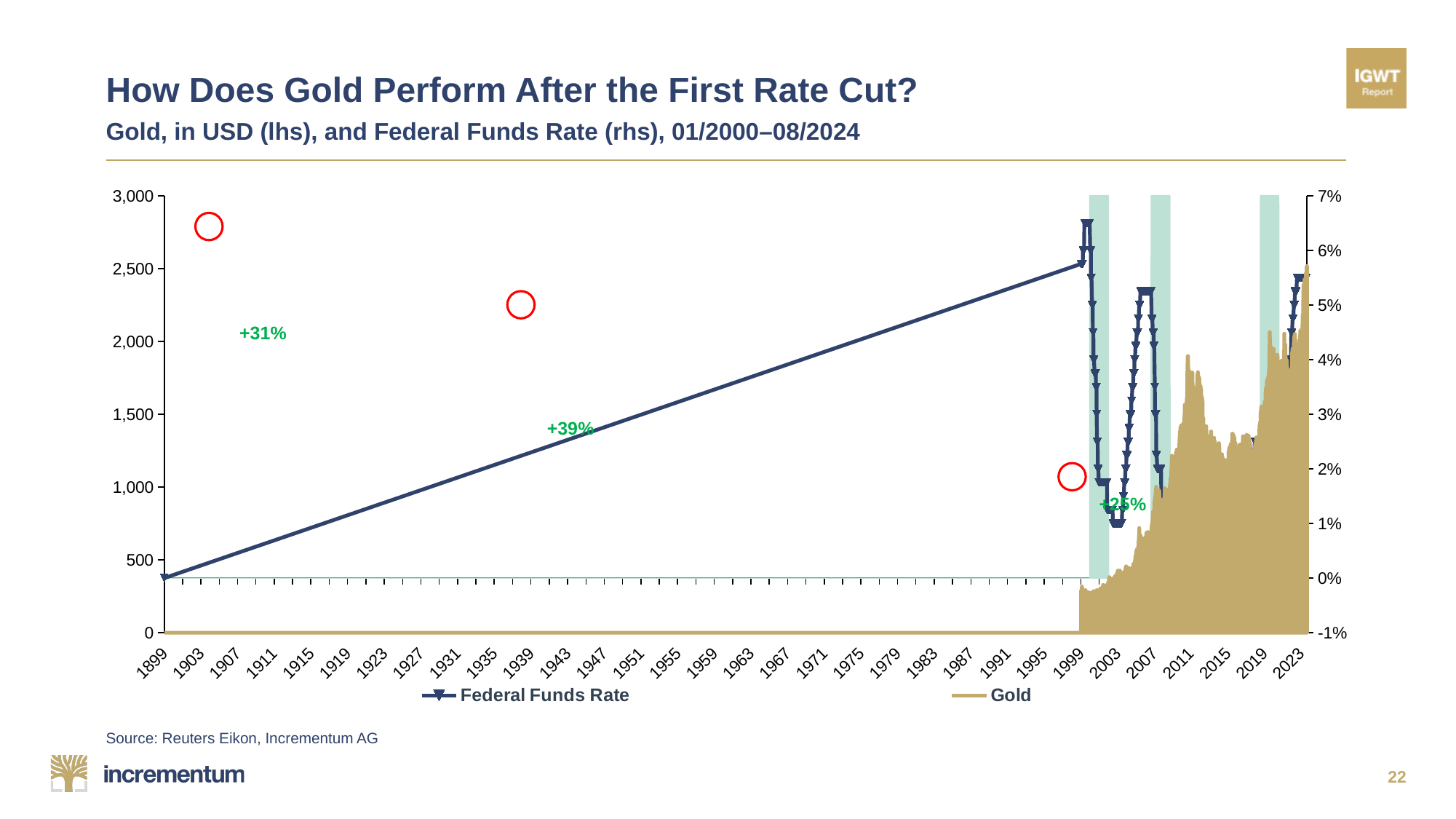
Which of the green percentage annotations on the chart is the largest? +39% Which two series are listed in the chart legend? Federal Funds Rate and Gold How many green percentage annotations are printed on the chart? 3 What is the highest value shown on the left-hand axis? 3,000 What is the highest value shown on the right-hand axis? 7% Which series is plotted on the right-hand axis (rhs)? Federal Funds Rate What kind of chart is shown on the slide? A combined line and area chart How many series does the legend list? 2 What is the lowest value shown on the right-hand axis? -1% Is the Gold value at the right end of the chart (around 2023) greater or less than 2,000? greater Does the Gold series rise or fall overall from 2000 to the end of the chart? rise Which of the green percentage annotations on the chart is the smallest? +25%